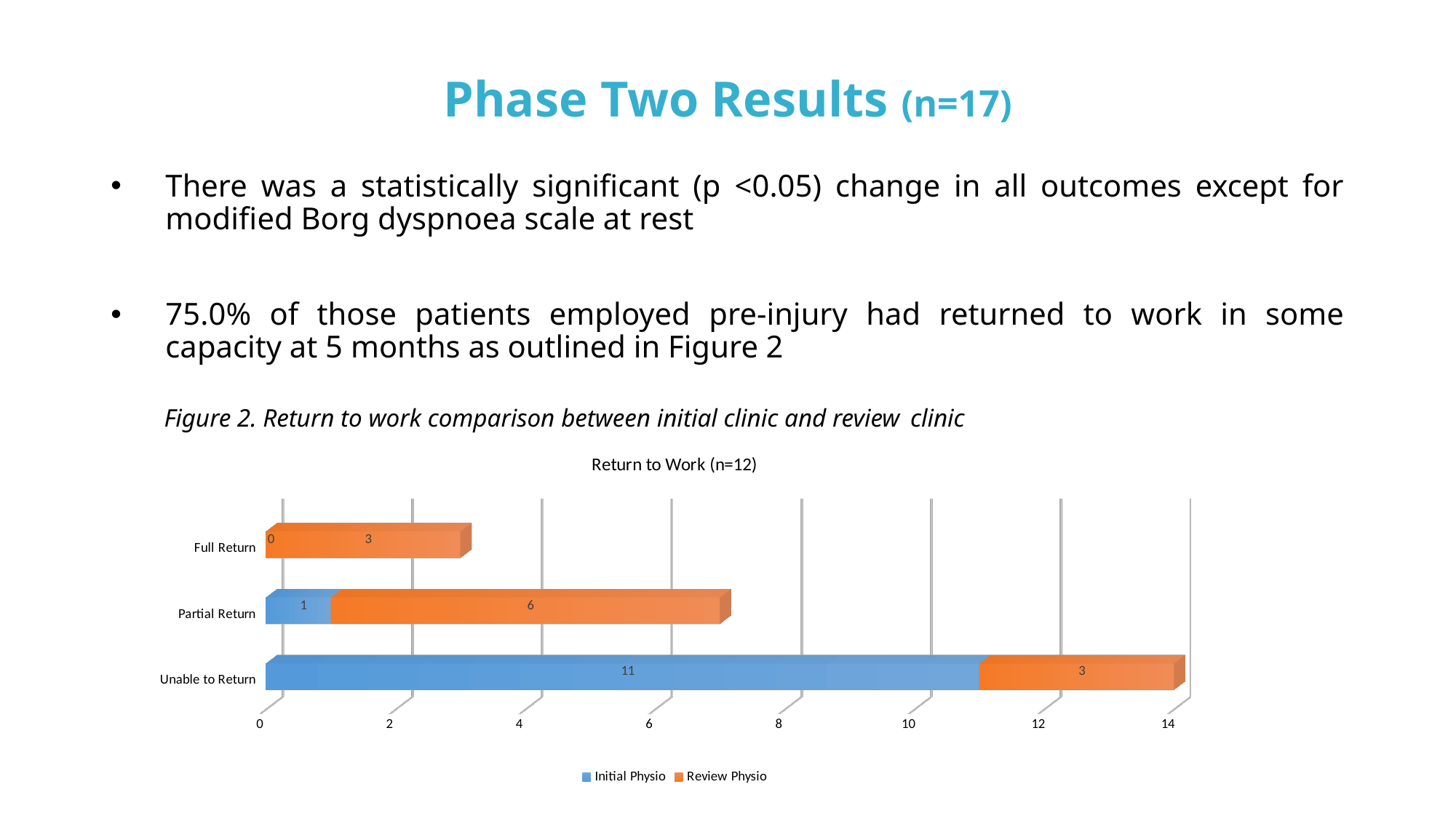
Which category has the lowest Initial Physio value? Full Return What type of chart is shown? Stacked bar chart Which category has the highest Review Physio value? Partial Return What is the Initial Physio value for Unable to Return? 11 What is the Review Physio value for Full Return? 3 What is the Initial Physio value for Full Return? 0 What is the total of the stacked bar for Unable to Return? 14 What is the difference between the Initial Physio and Review Physio values for Unable to Return? 8 Which is larger for Partial Return: the Initial Physio value or the Review Physio value? Review Physio What is the Review Physio value for Partial Return? 6 How many categories are shown on the chart? 3 How many series does the legend list? 2